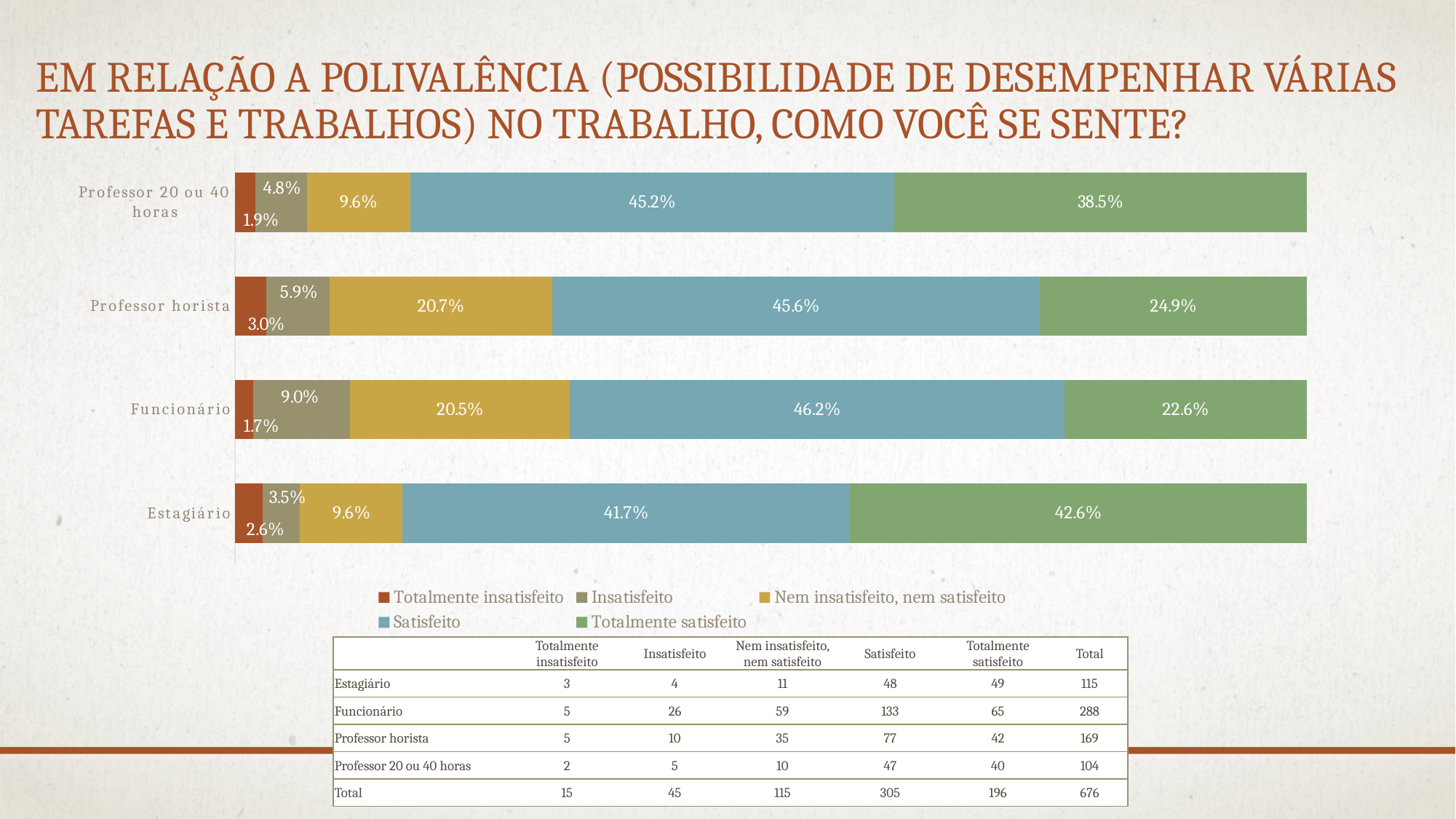
What is the value for Totalmente satisfeito in the Estagiário bar? 42.6% Which category has the lowest value for Totalmente insatisfeito? Funcionário Which category has the highest value for Totalmente satisfeito? Estagiário Which category has the highest value for Insatisfeito? Funcionário What is the value for Satisfeito in the Funcionário bar? 46.2% What is the difference between the Nem insatisfeito, nem satisfeito values for Professor horista and Professor 20 ou 40 horas? 11.1 percentage points What kind of chart is shown on the slide? Stacked bar chart What is the value for Nem insatisfeito, nem satisfeito in the Professor horista bar? 20.7% How many series does the legend list? 5 Which has a larger Satisfeito value, Professor horista or Professor 20 ou 40 horas? Professor horista What is the value for Insatisfeito in the Funcionário bar? 9.0% How many categories (bars) are shown in the chart? 4